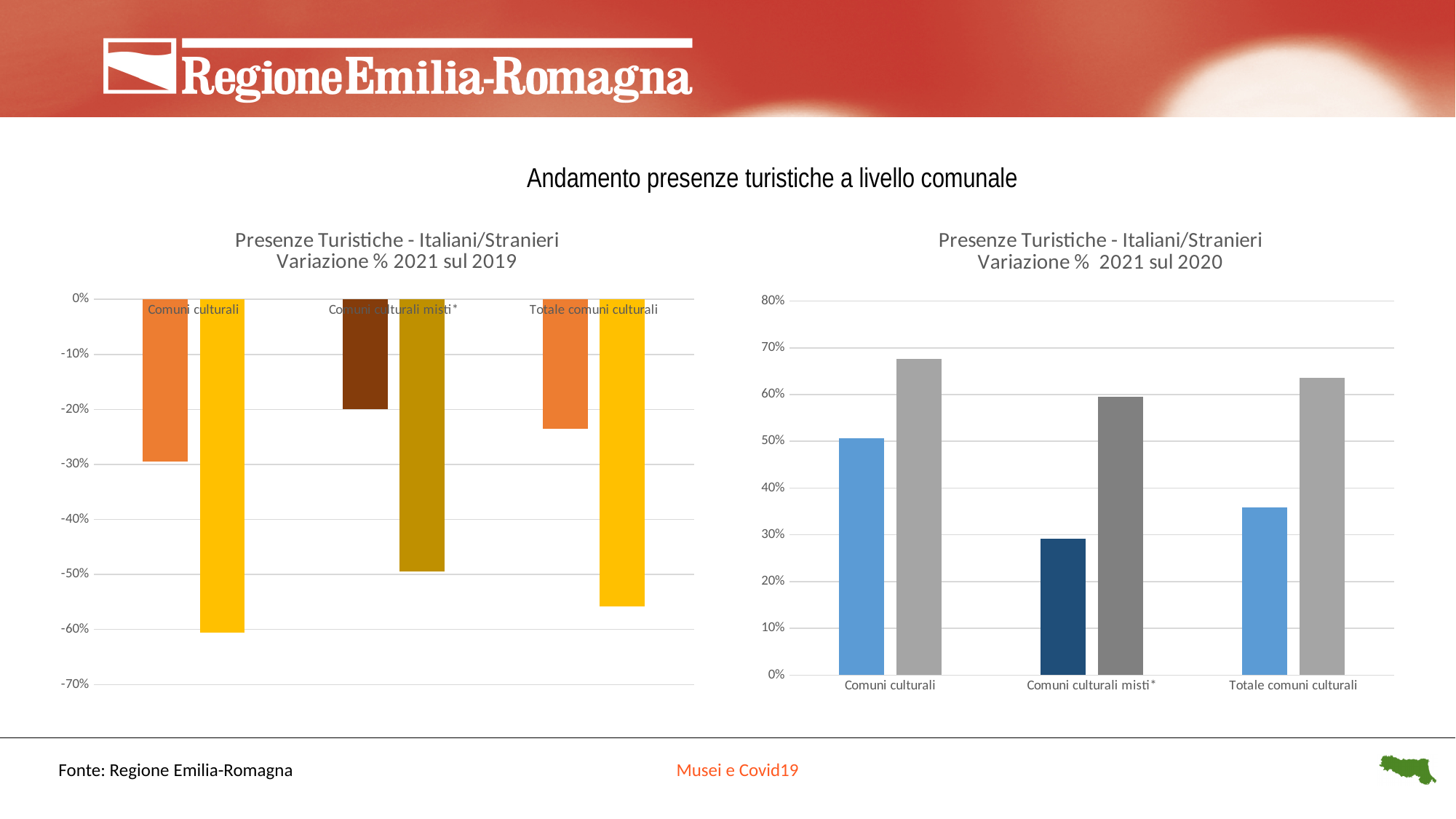
What is the title of the right chart? Presenze Turistiche - Italiani/Stranieri Variazione % 2021 sul 2020 In the right chart, 'Variazione % 2021 sul 2020', which bar for Comuni culturali misti* is taller, the first (dark blue) or the second (grey)? the second (grey) How many categories are shown on the x axis of the left chart, 'Variazione % 2021 sul 2019'? 3 In the right chart, 'Variazione % 2021 sul 2020', is the value of the first (dark blue) bar for Comuni culturali misti* greater or less than 20%? greater In the left chart, 'Variazione % 2021 sul 2019', which category has the most negative first (left) bar? Comuni culturali In the right chart, 'Variazione % 2021 sul 2020', which category has the lowest first (blue) bar? Comuni culturali misti* How many categories are shown on the x axis of the right chart, 'Variazione % 2021 sul 2020'? 3 In the left chart, 'Variazione % 2021 sul 2019', is the value of the second (yellow) bar for Comuni culturali greater or less than -50%? less In the right chart, 'Variazione % 2021 sul 2020', is the value of the second (grey) bar for Comuni culturali greater or less than 60%? greater What kind of chart is the left chart, 'Variazione % 2021 sul 2019'? bar chart In the right chart, 'Variazione % 2021 sul 2020', which category has the highest first (blue) bar? Comuni culturali